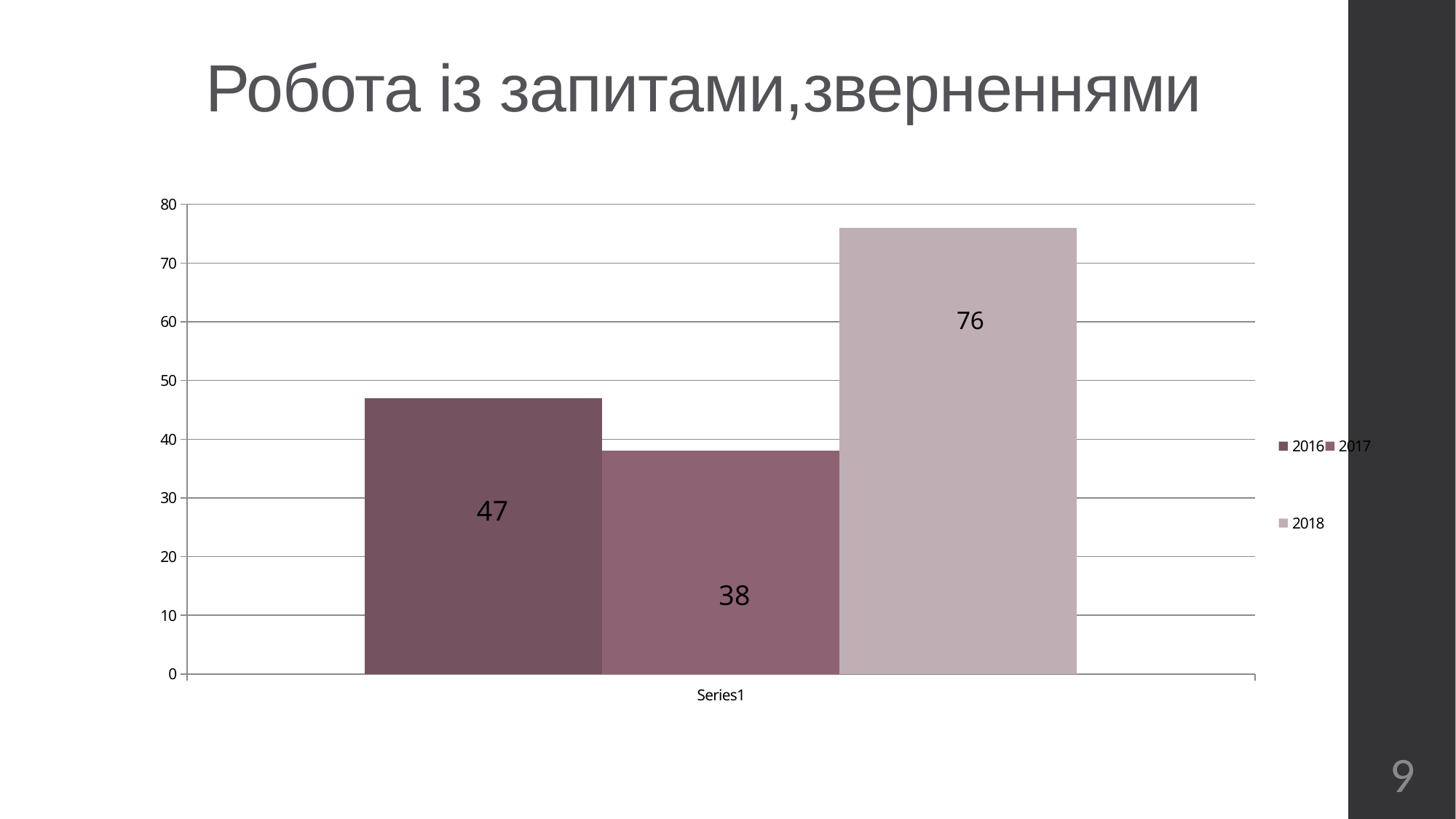
What is the value for 2017? 38 What is the title of the slide containing the chart? Робота із запитами,зверненнями What is the difference between the values for 2018 and 2016? 29 What is the value for 2016? 47 Is the value for 2018 greater or less than 70? greater What is the difference between the values for 2016 and 2017? 9 How many series does the legend list? 3 What is the value for 2018? 76 Which year has the lowest value? 2017 What kind of chart is shown on the slide? bar chart Which year has the highest value? 2018 Which is larger, the value for 2016 or the value for 2017? 2016